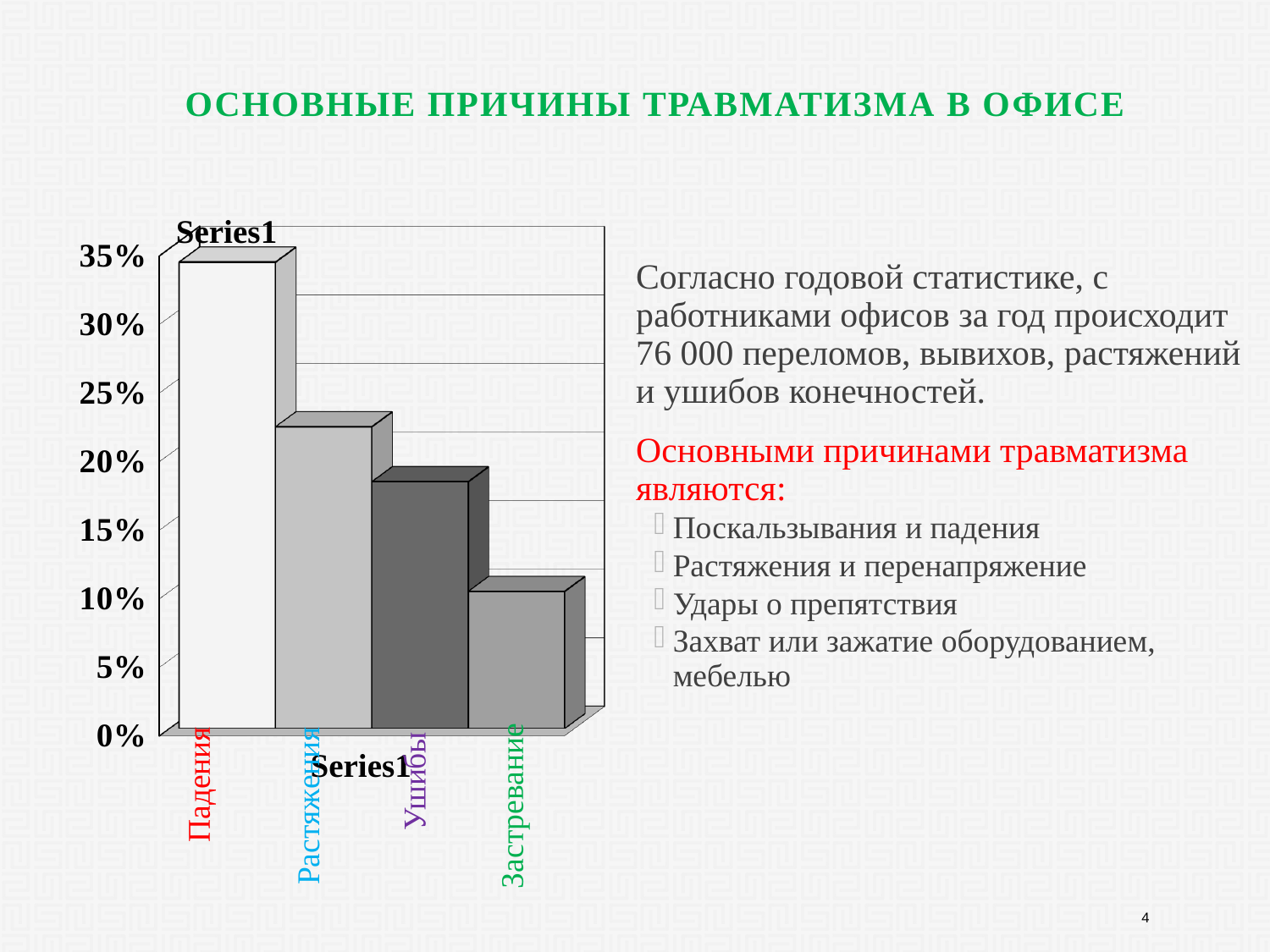
Is the value for Ушибы greater or less than 15%? greater How many categories are plotted on the chart? 4 How many series does the chart's legend list? 1 Which category has the lowest value on the chart? Застревание Which category has the highest value on the chart? Падения What kind of chart is shown on the slide? Bar chart Do the values rise or fall from left to right along the x axis? Fall Which is larger, the value for Растяжения or the value for Ушибы? Растяжения What is the name of the series shown in the chart's legend? Series1 Is the value for Падения greater or less than 30%? greater Is the value for Растяжения greater or less than 25%? less Which is larger, the value for Ушибы or the value for Застревание? Ушибы